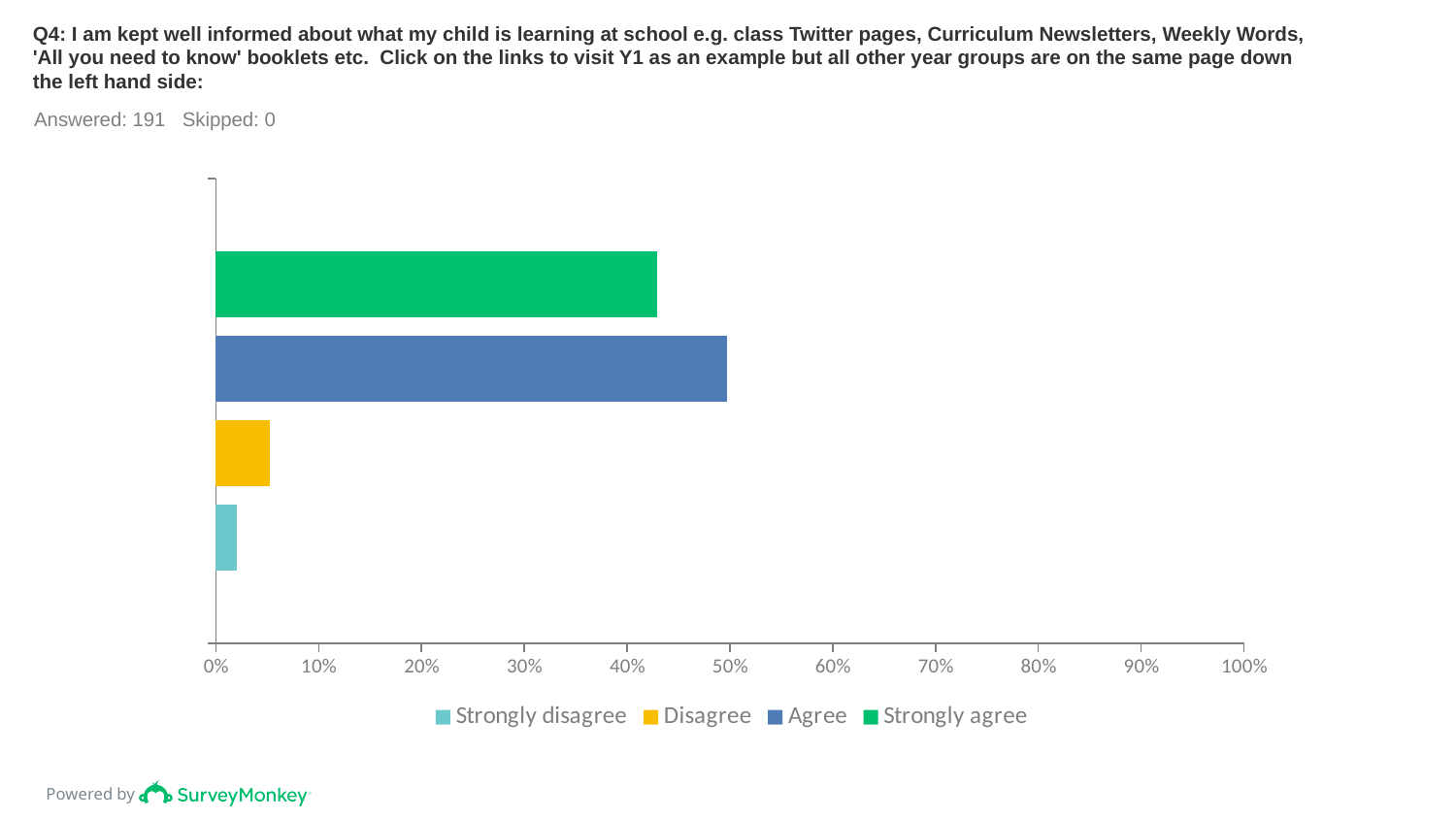
What kind of chart is shown on the slide? bar chart How many entries does the legend list? 4 Is the value for Strongly disagree greater or less than 10%? less Is the value for Strongly agree greater or less than 40%? greater Which response has the longest bar? Agree Which is larger, the value for Agree or the value for Strongly agree? Agree How many bars are plotted in the chart? 4 Which is larger, the value for Disagree or the value for Strongly disagree? Disagree Is the value for Disagree greater or less than 10%? less What colour is used for the Strongly agree bar? green How many respondents answered this question according to the slide? 191 Which response has the shortest bar? Strongly disagree